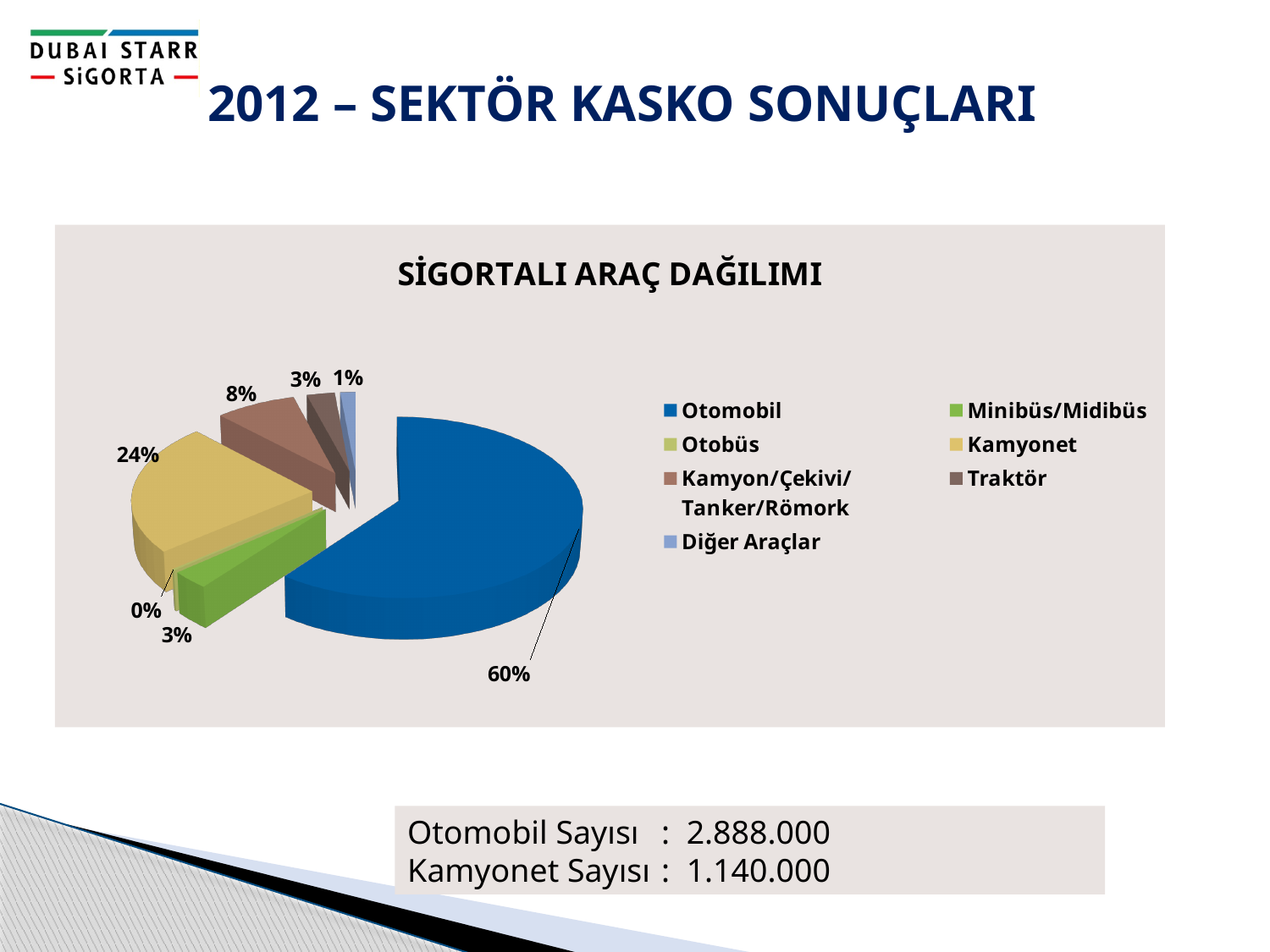
What type of chart is shown on the slide? pie chart What share of the pie does Otomobil have? 60% How many percentage points larger is the Otomobil share than the Kamyonet share? 36 What share of the pie does Diğer Araçlar have? 1% What share of the pie does Kamyon/Çekivi/Tanker/Römork have? 8% What is the title of the chart? SİGORTALI ARAÇ DAĞILIMI Which has a larger share, Kamyonet or Kamyon/Çekivi/Tanker/Römork? Kamyonet Which category has the smallest share of the pie? Otobüs What share of the pie does Otobüs have? 0% How many categories does the legend list? 7 Which category has the largest share of the pie? Otomobil What share of the pie does Kamyonet have? 24%